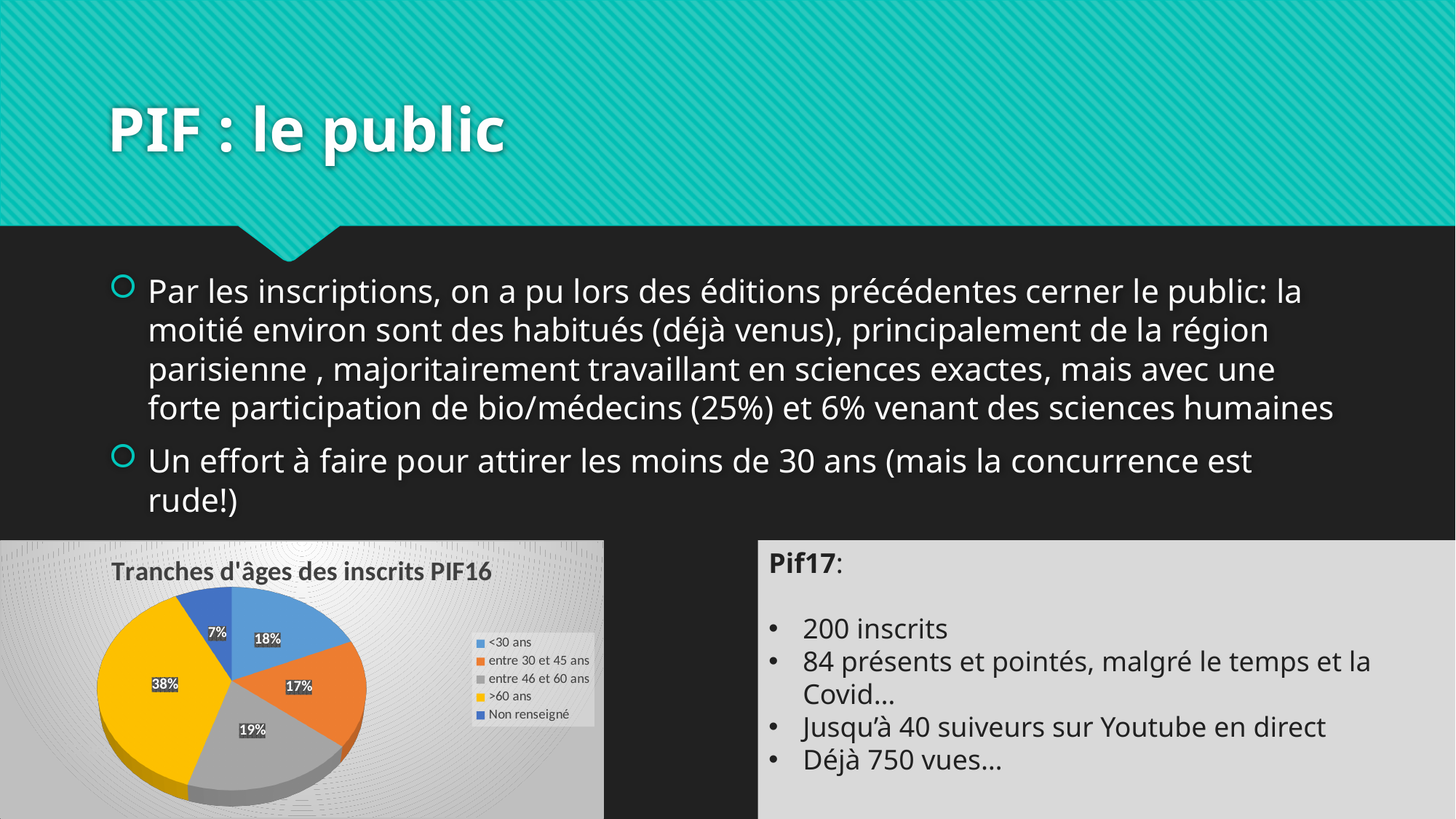
What share of the pie does the '>60 ans' slice represent? 38% Which is larger, the slice for 'entre 46 et 60 ans' or the slice for 'Non renseigné'? entre 46 et 60 ans What kind of chart is shown on the slide? pie chart Which age category has the largest slice of the pie? >60 ans What is the difference in percentage points between the '>60 ans' slice and the '<30 ans' slice? 20 What is the value shown for 'Non renseigné'? 7% What is the title of the chart? Tranches d'âges des inscrits PIF16 How many categories does the pie chart have? 5 What colour is the '>60 ans' slice in the pie chart? yellow What is the value shown for '<30 ans'? 18% What is the value shown for 'entre 46 et 60 ans'? 19% Which category has the smallest slice of the pie? Non renseigné